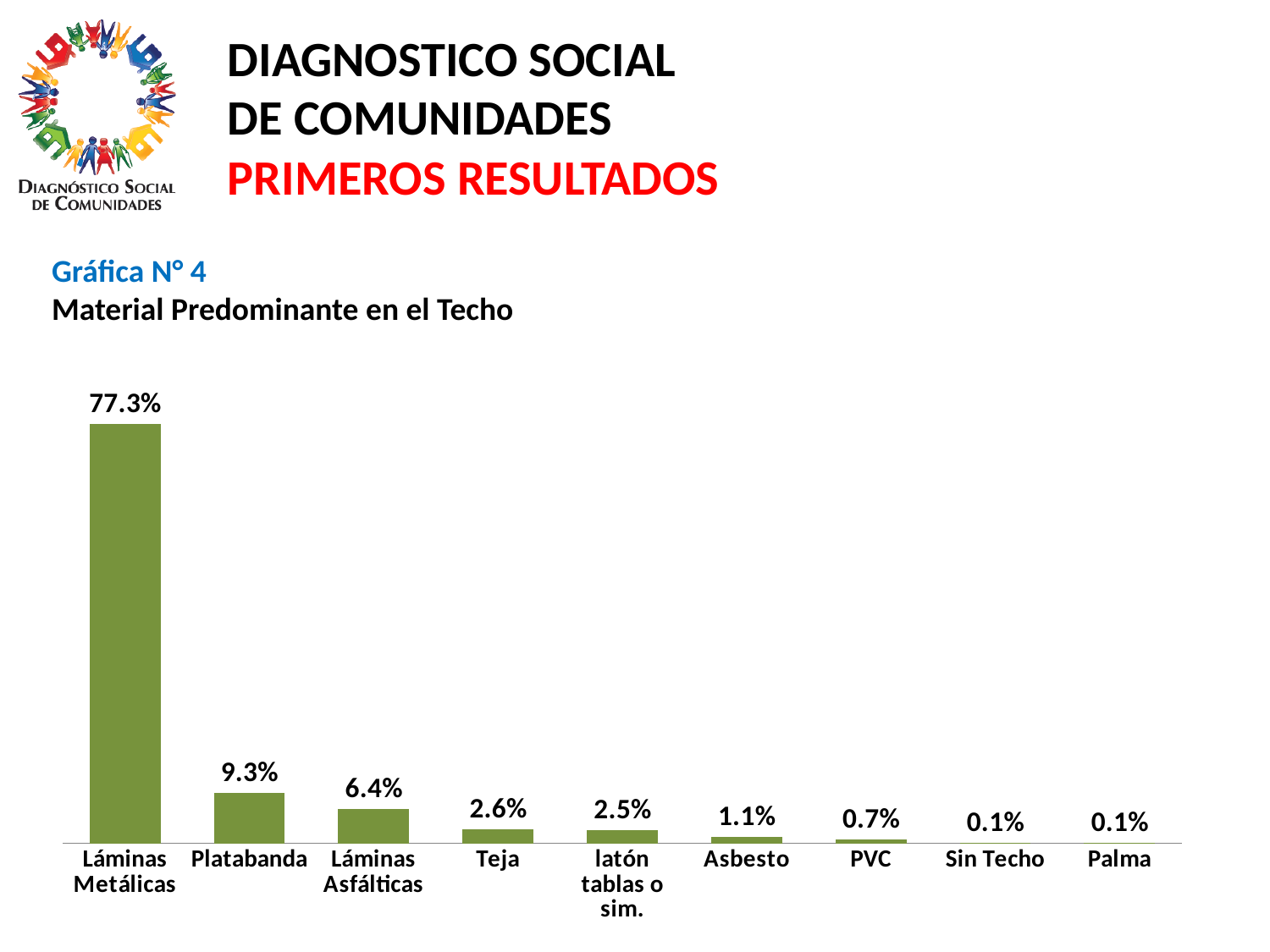
What is the value for PVC? 0.7% What is the difference between the values for Platabanda and Láminas Asfálticas? 2.9% What is the title of the chart? Material Predominante en el Techo What is the value for Platabanda? 9.3% How many categories are shown on the x axis? 9 Do the values rise or fall from left to right along the x axis? Fall What is the value for Teja? 2.6% What kind of chart is shown on the slide? Bar chart Which is larger, the value for Teja or the value for latón tablas o sim.? Teja What is the value for Láminas Metálicas? 77.3% What is the value for Asbesto? 1.1% Which category has the highest value? Láminas Metálicas